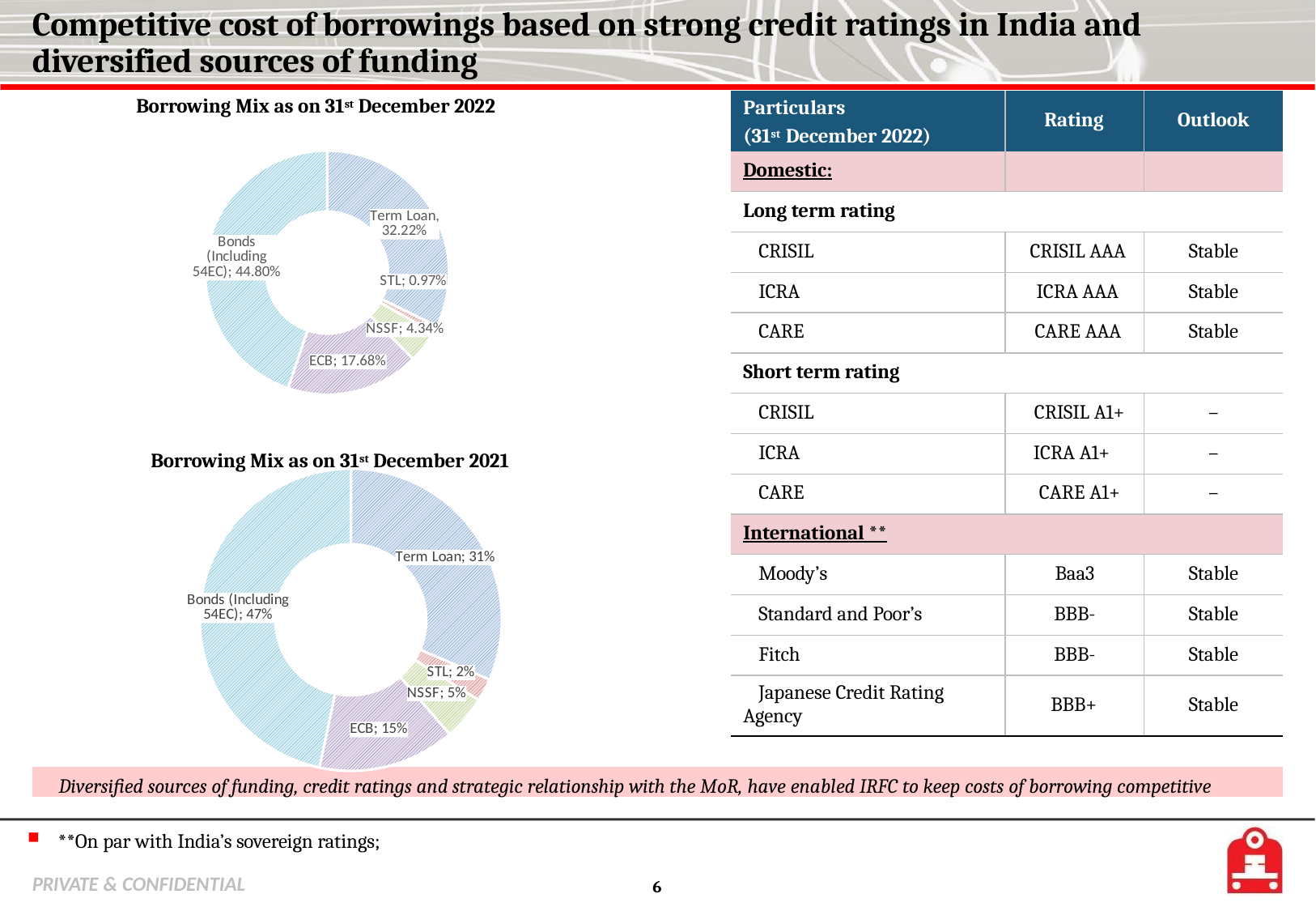
In the 'Borrowing Mix as on 31st December 2022' chart, what is the difference between the Term Loan share and the ECB share? 14.54% In the 'Borrowing Mix as on 31st December 2021' chart, what share does Term Loan account for? 31% In the 'Borrowing Mix as on 31st December 2022' chart, which category has the largest share? Bonds (Including 54EC) What type of chart is used for the 'Borrowing Mix as on 31st December 2021'? Doughnut (pie) chart In the 'Borrowing Mix as on 31st December 2021' chart, which is larger: the ECB share or the NSSF share? ECB In the 'Borrowing Mix as on 31st December 2022' chart, what is the share of Bonds (Including 54EC)? 44.80% How many categories are shown in the 'Borrowing Mix as on 31st December 2022' chart? 5 In the 'Borrowing Mix as on 31st December 2022' chart, what share does ECB account for? 17.68% In the 'Borrowing Mix as on 31st December 2022' chart, which category has the smallest share? STL In the 'Borrowing Mix as on 31st December 2021' chart, what is the difference between the Bonds (Including 54EC) share and the Term Loan share? 16% In the 'Borrowing Mix as on 31st December 2021' chart, which category has the smallest share? STL In the 'Borrowing Mix as on 31st December 2021' chart, what is the share of NSSF? 5%